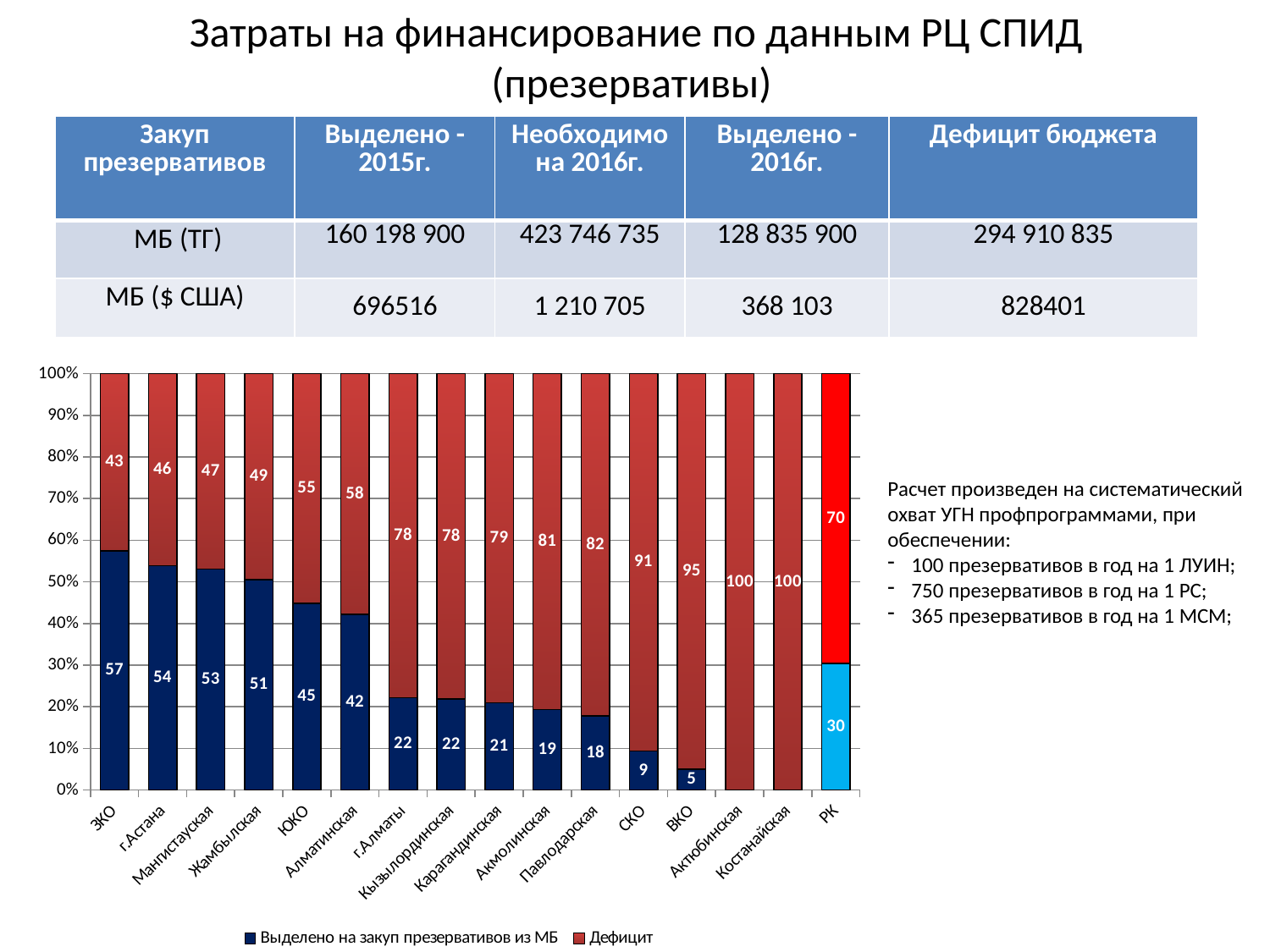
Which is larger: the 'Выделено на закуп презервативов из МБ' value for ЮКО or for г.Алматы? ЮКО How many series does the chart legend list? 2 What is the value of the 'Дефицит' series for Павлодарская? 82 Which category has the highest value for 'Выделено на закуп презервативов из МБ'? ЗКО What kind of chart is shown on the slide? stacked bar chart What is the value of the 'Выделено на закуп презервативов из МБ' series for ЗКО? 57 How many categories are shown on the x axis of the chart? 16 Does the 'Дефицит' share for Актюбинская and Костанайская reach 100%? yes, 100 What is the difference between the 'Дефицит' values for СКО and ЗКО? 48 What is the value of the 'Дефицит' series for РК? 70 Which category has the lowest labelled value for 'Выделено на закуп презервативов из МБ'? ВКО What is the second legend entry of the chart? Дефицит